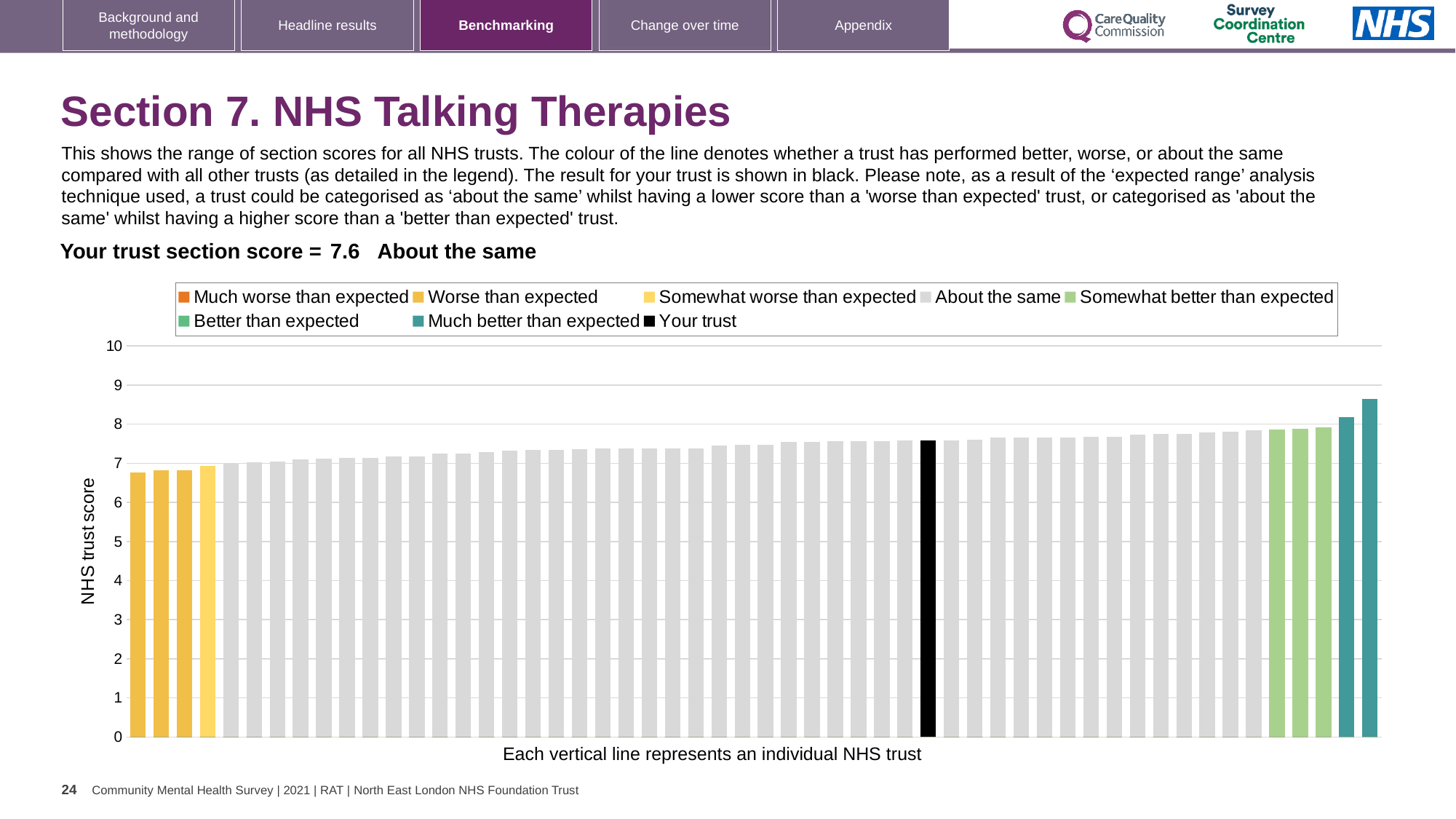
Which category is your trust placed in for this section? About the same Which legend category does the highest bar belong to? Much better than expected How many entries does the chart legend list? 8 What colour is the bar representing your trust? black Is the value of the highest bar greater or less than 8? greater What is the label on the y axis of the chart? NHS trust score Do the bar values rise or fall from left to right along the x axis? rise Is the value of the lowest bar greater or less than 7? less What is the section score for your trust? 7.6 What kind of chart is shown on the slide? bar chart Is the value of the highest bar greater or less than 9? less